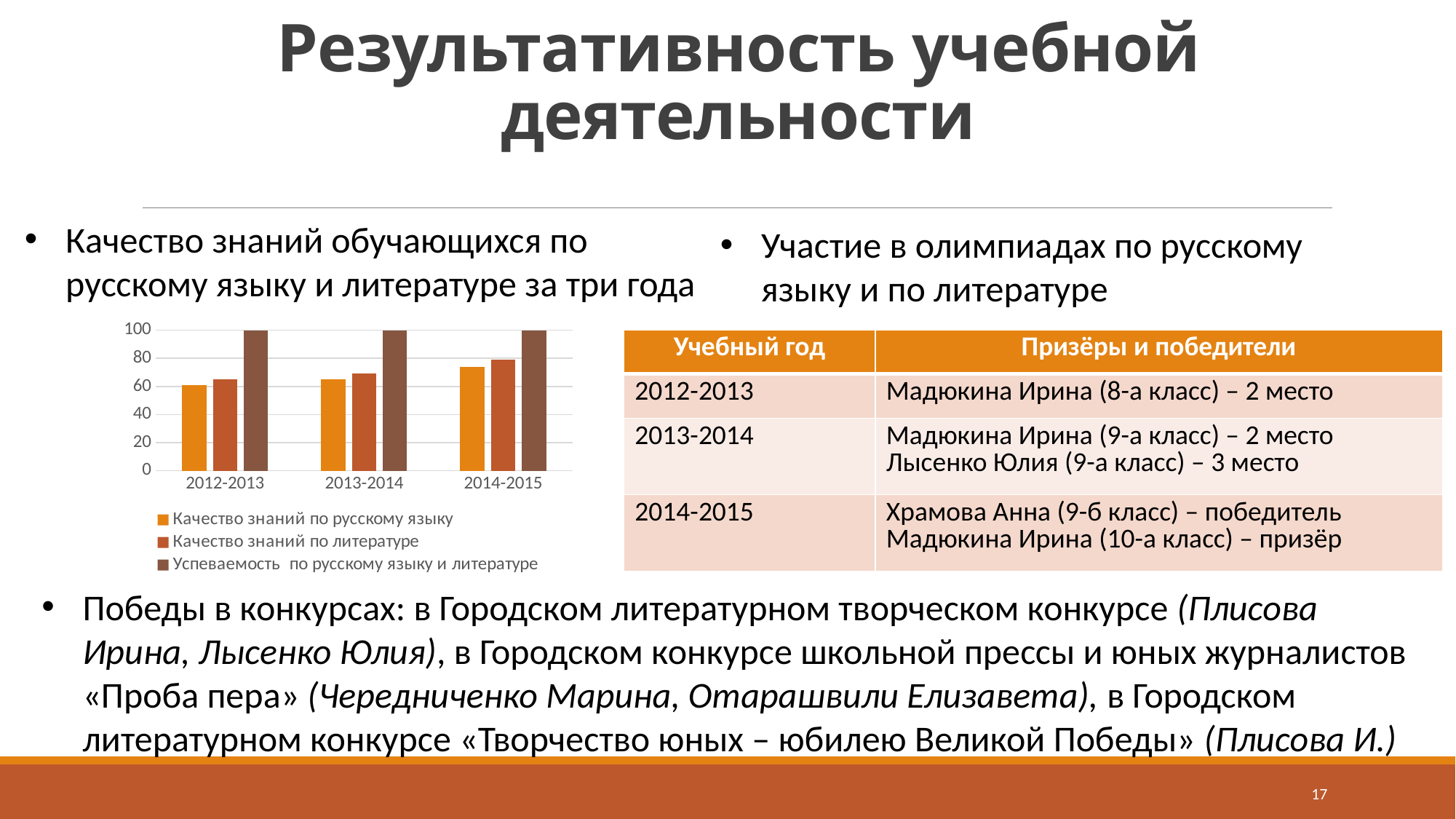
What is the value of Успеваемость по русскому языку и литературе for 2012-2013? 100 Does Качество знаний по русскому языку rise or fall from 2012-2013 to 2014-2015? rise Which year has the lowest value for Качество знаний по литературе? 2012-2013 Is the value for Качество знаний по литературе in 2013-2014 greater or less than 80? less Which year has the highest value for Качество знаний по русскому языку? 2014-2015 Which is larger: Качество знаний по литературе in 2014-2015 or in 2012-2013? 2014-2015 How many series does the chart legend list? 3 What is the value of Успеваемость по русскому языку и литературе for 2014-2015? 100 Is the value for Качество знаний по русскому языку in 2012-2013 greater or less than 80? less Is the value for Качество знаний по русскому языку in 2014-2015 greater or less than 60? greater How many academic years are shown on the x axis of the chart? 3 What kind of chart is shown on the slide? bar chart